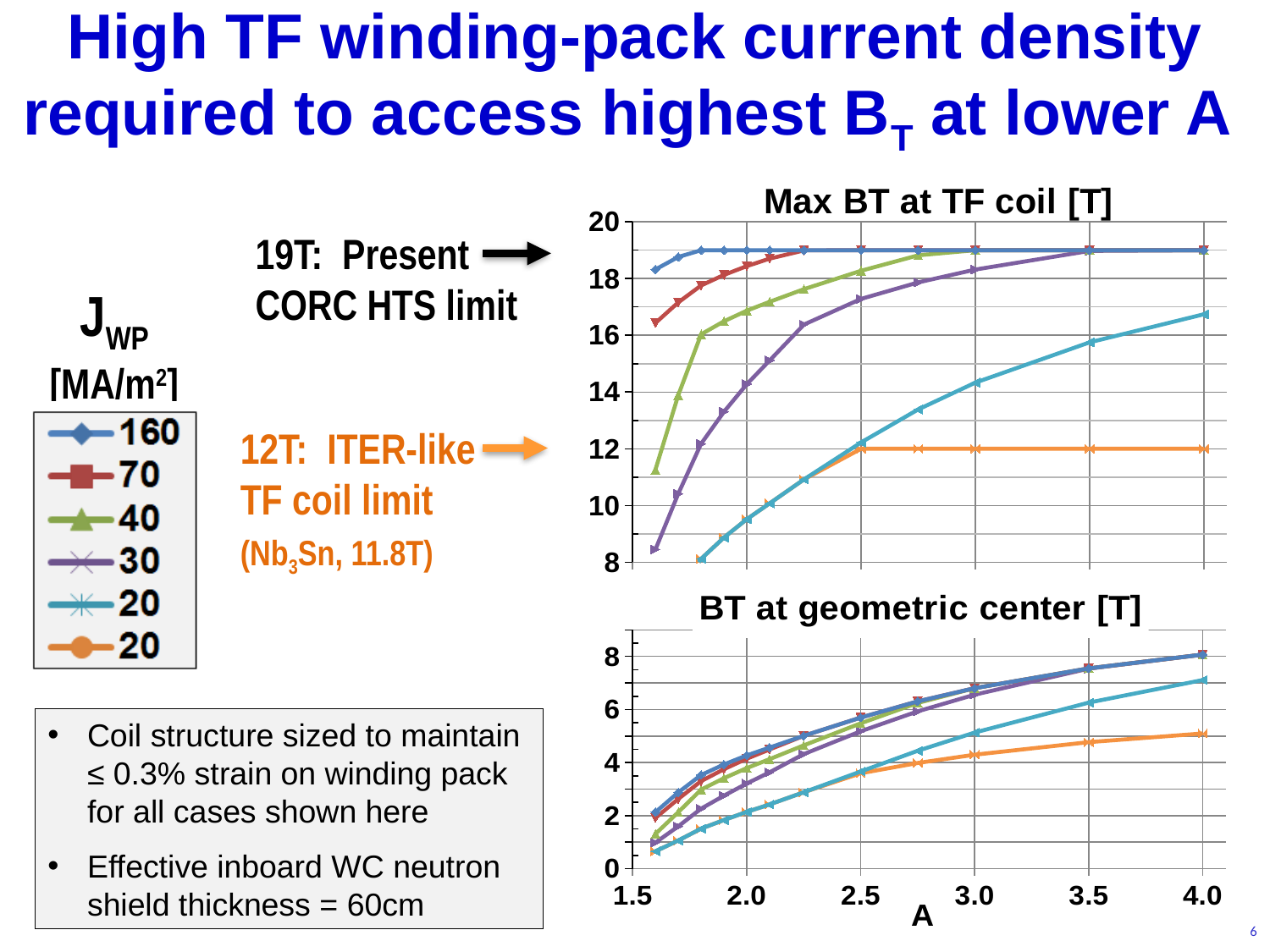
In the "Max BT at TF coil [T]" chart, is the value of the 40 series at A = 1.6 greater or less than 12? less In the "Max BT at TF coil [T]" chart, is the value of the 30 series at A = 1.6 greater or less than 10? less What kind of chart is the "Max BT at TF coil [T]" chart? line chart How many series does the legend list for the charts? 6 In the "Max BT at TF coil [T]" chart, what is the value of the orange 20 series at A = 4.0? 12 What is the label on the x axis of the charts? A In the "Max BT at TF coil [T]" chart, at A = 2.0, which series has the larger value, 70 or 40? 70 In the "BT at geometric center [T]" chart, is the value of the orange 20 series at A = 4.0 greater or less than 6? less In the "Max BT at TF coil [T]" chart, which series has the highest value at A = 1.6? 160 In the "Max BT at TF coil [T]" chart, what is the value of the orange 20 series at A = 3.0? 12 In the "BT at geometric center [T]" chart, does the 160 series rise or fall as A increases? rise